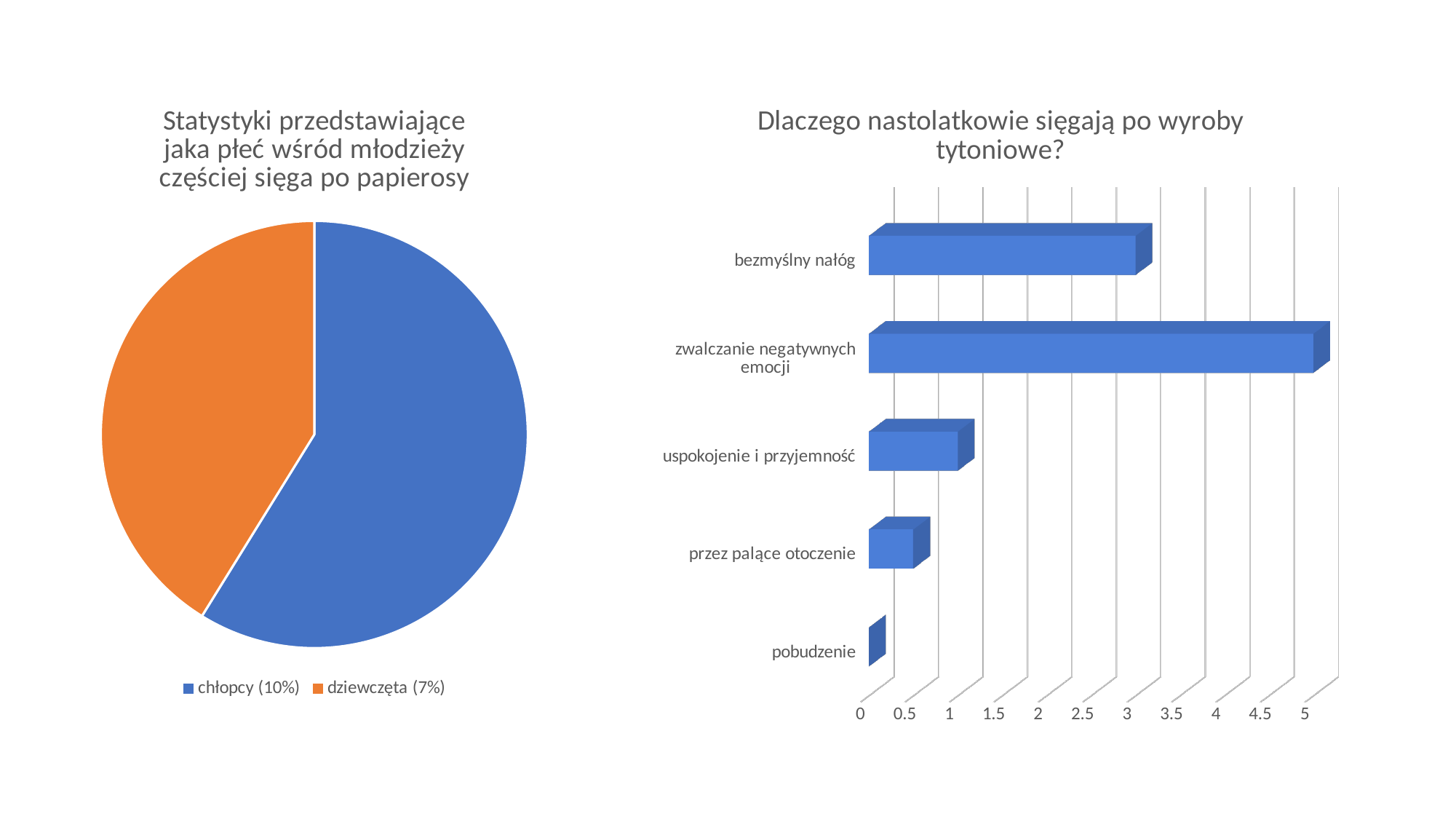
How many categories are shown in the right bar chart "Dlaczego nastolatkowie sięgają po wyroby tytoniowe?"? 5 In the right bar chart, which category has the highest value? zwalczanie negatywnych emocji In the right bar chart, is the value for uspokojenie i przyjemność greater or less than 2? less In the right bar chart, is the value for bezmyślny nałóg greater or less than 2? greater In the right bar chart, which category has the lowest value? pobudzenie In the left pie chart, which slice is larger, chłopcy or dziewczęta? chłopcy What kind of chart is the right chart titled "Dlaczego nastolatkowie sięgają po wyroby tytoniowe?"? bar chart What kind of chart is the left chart titled "Statystyki przedstawiające jaka płeć wśród młodzieży częściej sięga po papierosy"? pie chart How many slices does the left pie chart have? 2 In the right bar chart, which is larger, bezmyślny nałóg or uspokojenie i przyjemność? bezmyślny nałóg In the left pie chart, what percentage is shown in the legend for chłopcy? 10% In the left pie chart, what percentage is shown in the legend for dziewczęta? 7%